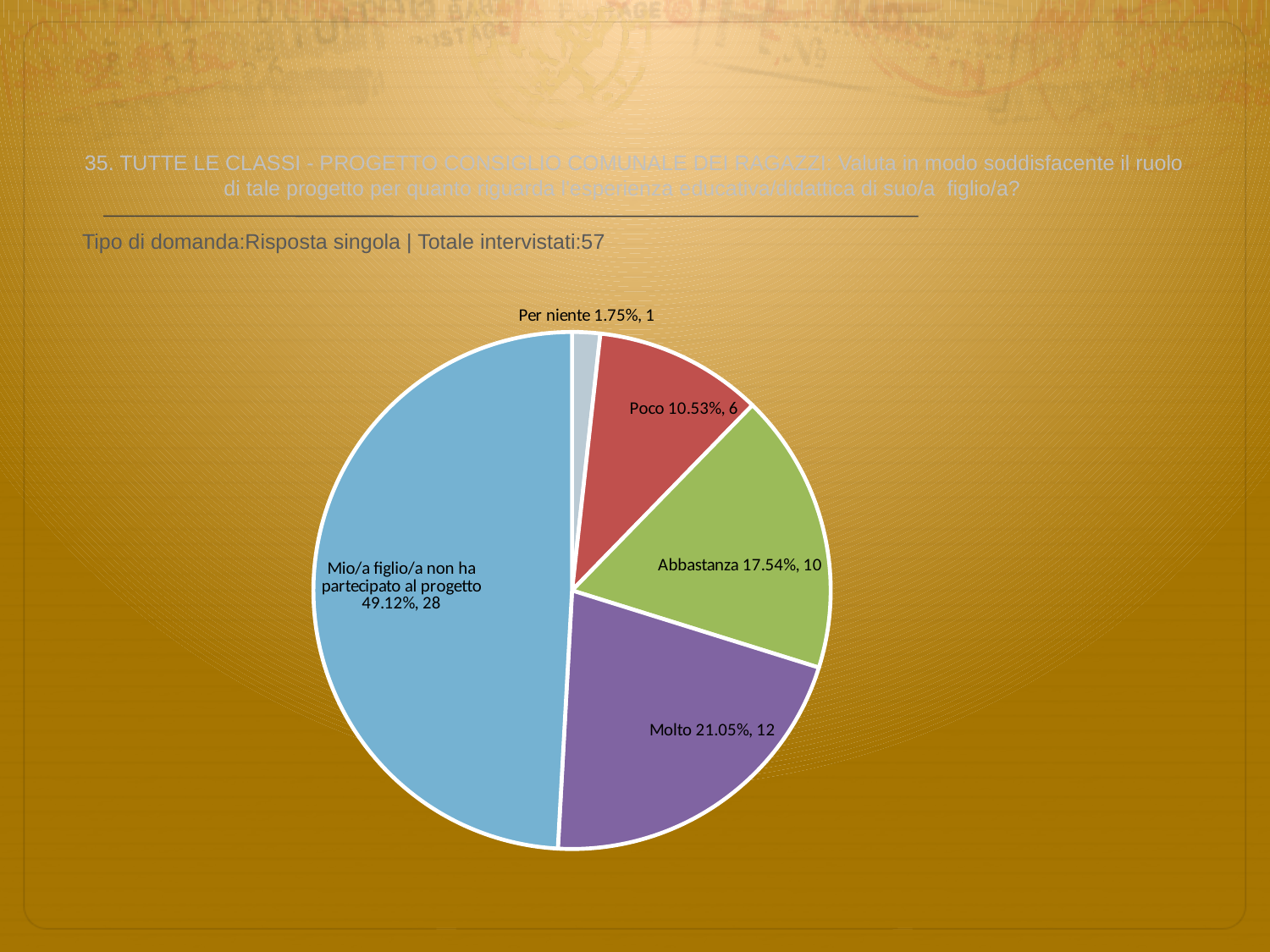
Which category has the largest slice of the pie? Mio/a figlio/a non ha partecipato al progetto How many respondents chose "Mio/a figlio/a non ha partecipato al progetto"? 28 Which has more respondents, "Poco" or "Abbastanza"? Abbastanza How many respondents answered "Abbastanza"? 10 What kind of chart is shown on the slide? pie chart What percentage share does the "Per niente" slice have? 1.75% Which category has the smallest slice of the pie? Per niente How many slices does the pie chart have? 5 What is the total number of respondents stated on the slide? 57 What is the difference in number of respondents between "Molto" and "Abbastanza"? 2 What percentage share does the "Molto" slice have? 21.05% How many respondents answered "Poco"? 6